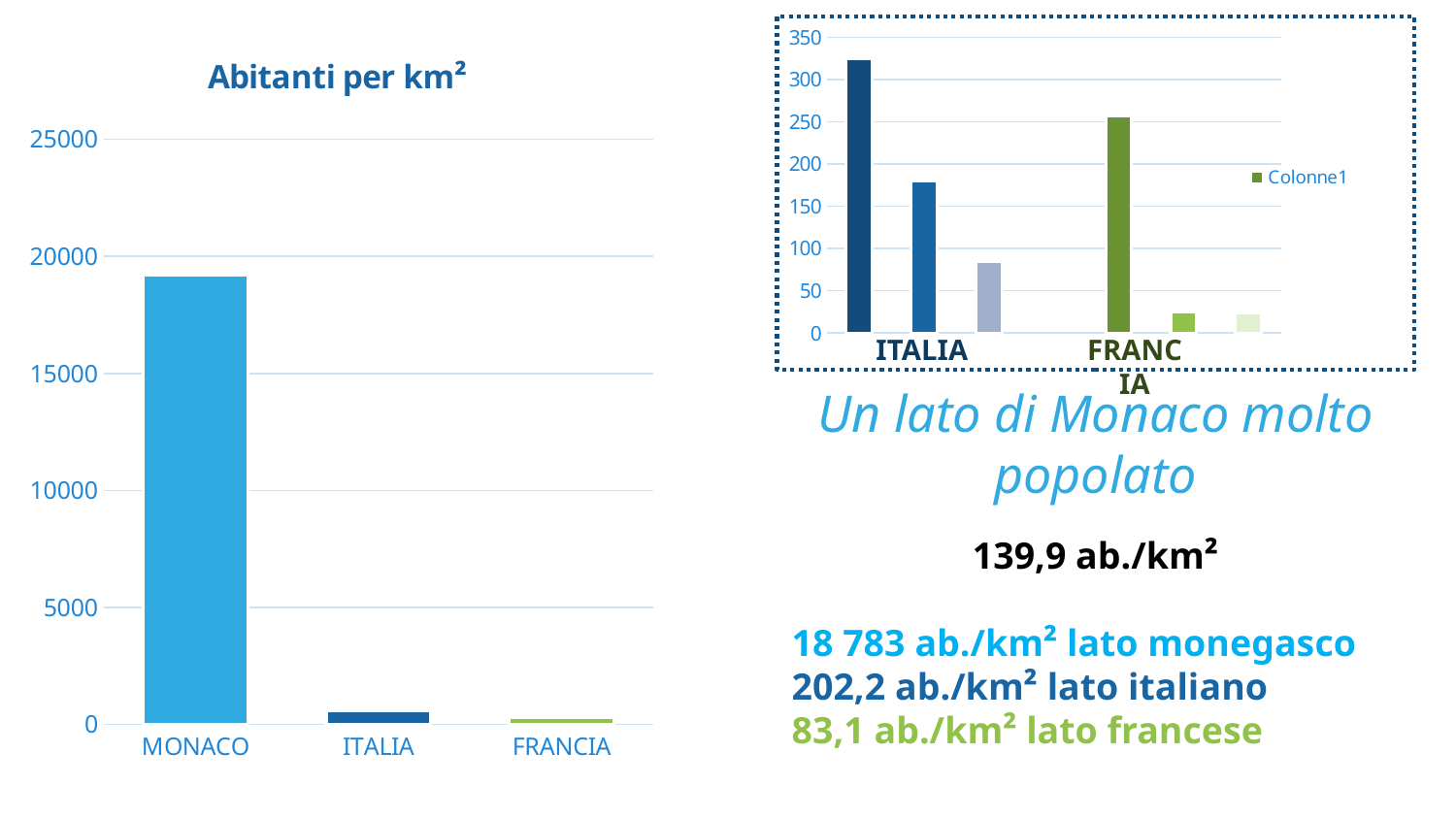
In the left chart "Abitanti per km²", is the value for MONACO greater or less than 20000? less In the left chart "Abitanti per km²", which category has the highest value? MONACO In the left chart "Abitanti per km²", is the value for ITALIA greater or less than 5000? less In the left chart "Abitanti per km²", which is larger, the value for MONACO or the value for ITALIA? MONACO In the right chart (top right of the slide), how many series does the legend list? 1 What kind of chart is the left chart titled "Abitanti per km²"? bar chart In the right chart (top right of the slide), is the tallest bar in the ITALIA group greater or less than 300? greater In the left chart "Abitanti per km²", which category has the lowest value? FRANCIA In the right chart (top right of the slide), how many category groups are shown on the x axis? 2 In the right chart (top right of the slide), what is the legend entry? Colonne1 In the left chart "Abitanti per km²", how many categories are shown on the x axis? 3